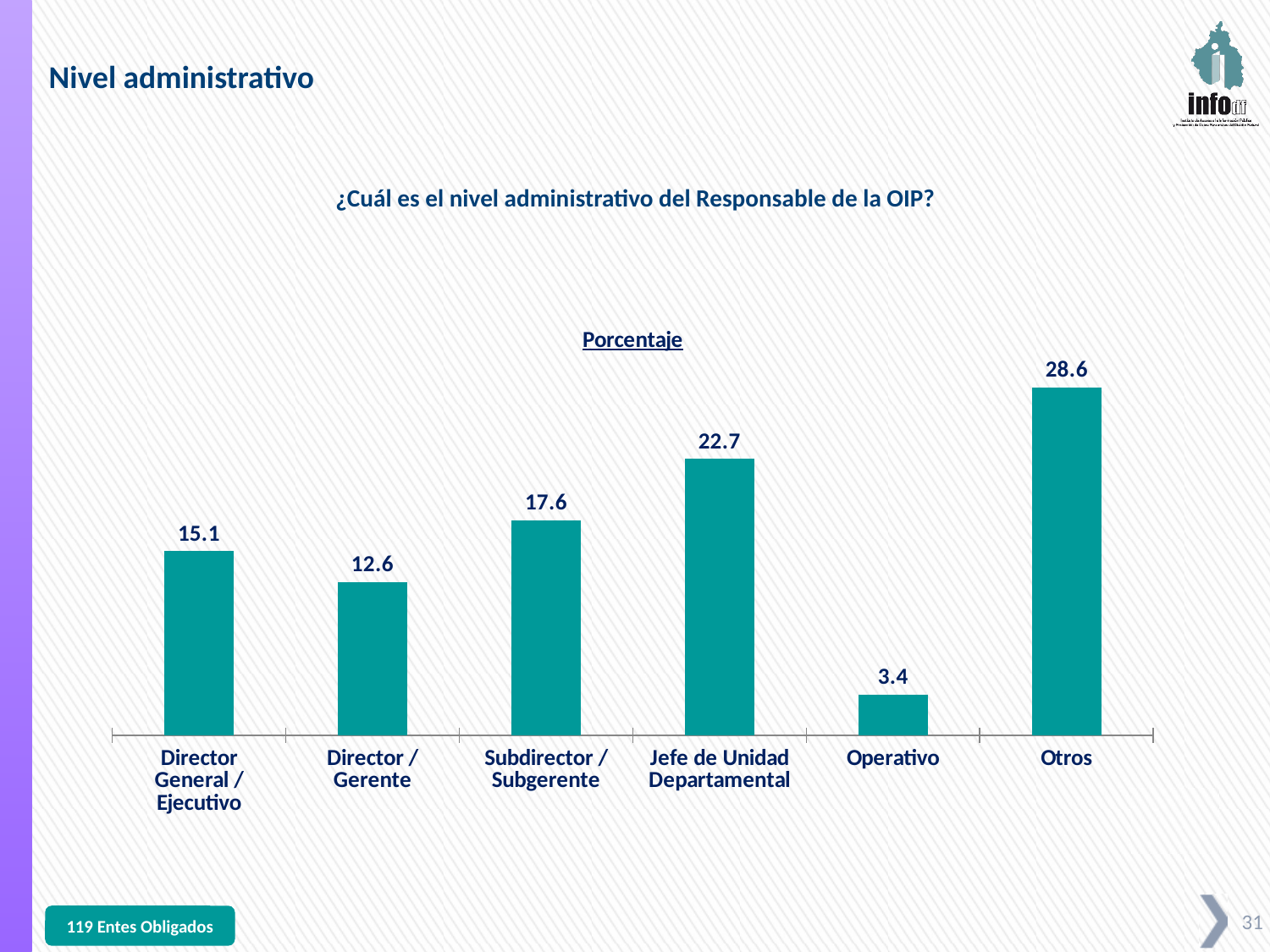
What is the title shown above the chart? Porcentaje What is the value for Operativo? 3.4 What is the value for Director General / Ejecutivo? 15.1 Which is larger, the value for Subdirector / Subgerente or the value for Director / Gerente? Subdirector / Subgerente What is the value for Otros? 28.6 What kind of chart is this? bar chart Which category has the lowest value? Operativo How many categories are shown on the x axis? 6 Which category has the highest value? Otros What is the difference between the values for Director General / Ejecutivo and Director / Gerente? 2.5 What is the value for Jefe de Unidad Departamental? 22.7 What is the difference between the values for Otros and Jefe de Unidad Departamental? 5.9